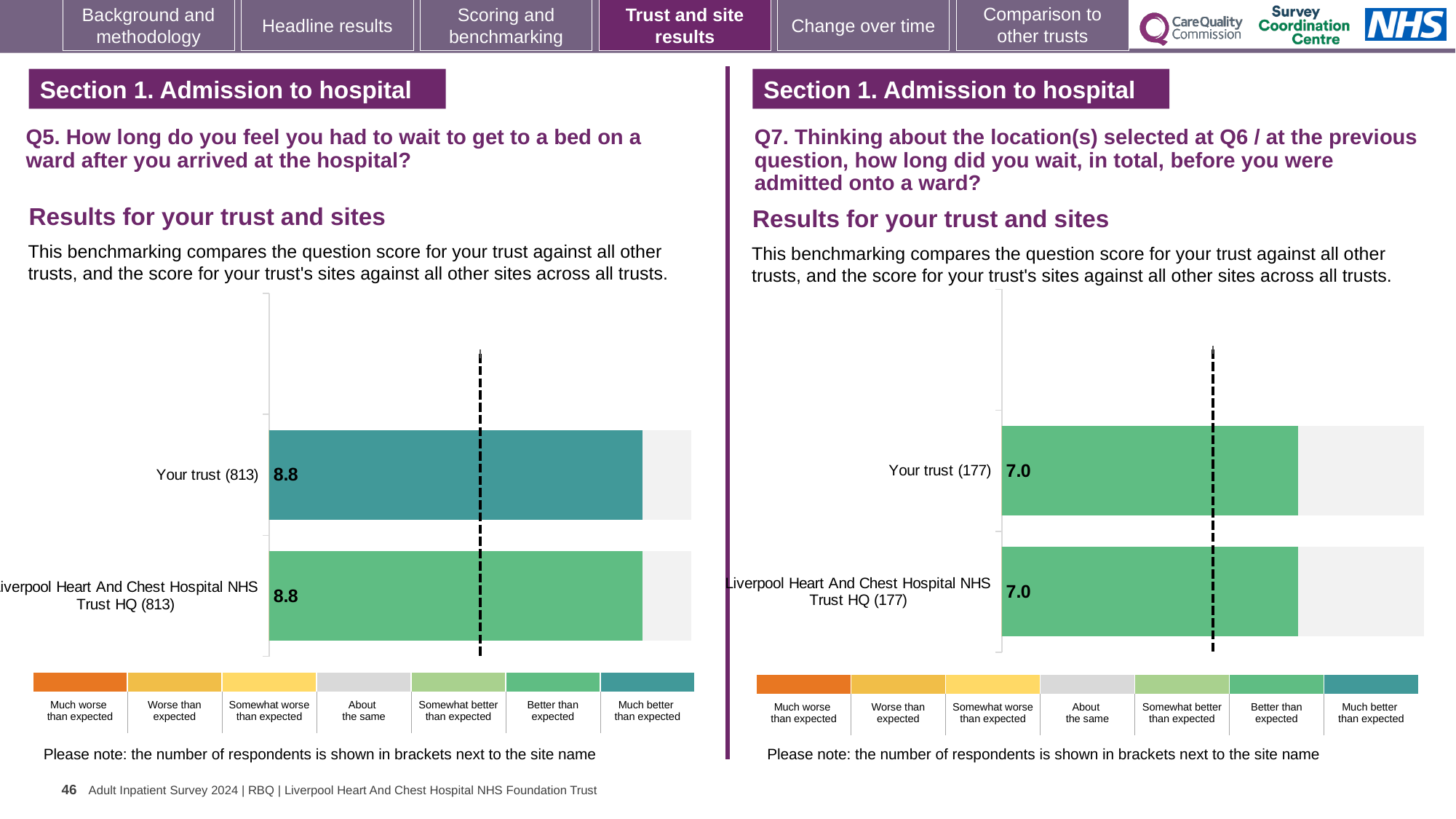
In the Q5 chart on the left, what is the difference between the score for Your trust and the score for Liverpool Heart And Chest Hospital NHS Trust HQ? 0.0 In the Q5 chart on the left, what is the score for Your trust? 8.8 In the Q5 chart on the left, which benchmark category does the colour of the Your trust bar correspond to in the key below the chart? Much better than expected How many bars are plotted in the Q7 chart on the right? 2 In the Q5 chart on the left, what is the score for Liverpool Heart And Chest Hospital NHS Trust HQ? 8.8 What kind of chart is used for the Q7 results on the right? Bar chart How many bars are plotted in the Q5 chart on the left? 2 In the Q7 chart on the right, how many respondents are shown in brackets for Liverpool Heart And Chest Hospital NHS Trust HQ? 177 In the Q7 chart on the right, what is the score for Liverpool Heart And Chest Hospital NHS Trust HQ? 7.0 In the Q7 chart on the right, what is the score for Your trust? 7.0 In the Q5 chart on the left, how many respondents are shown in brackets for Your trust? 813 In the Q7 chart on the right, what is the difference between the score for Your trust and the score for Liverpool Heart And Chest Hospital NHS Trust HQ? 0.0